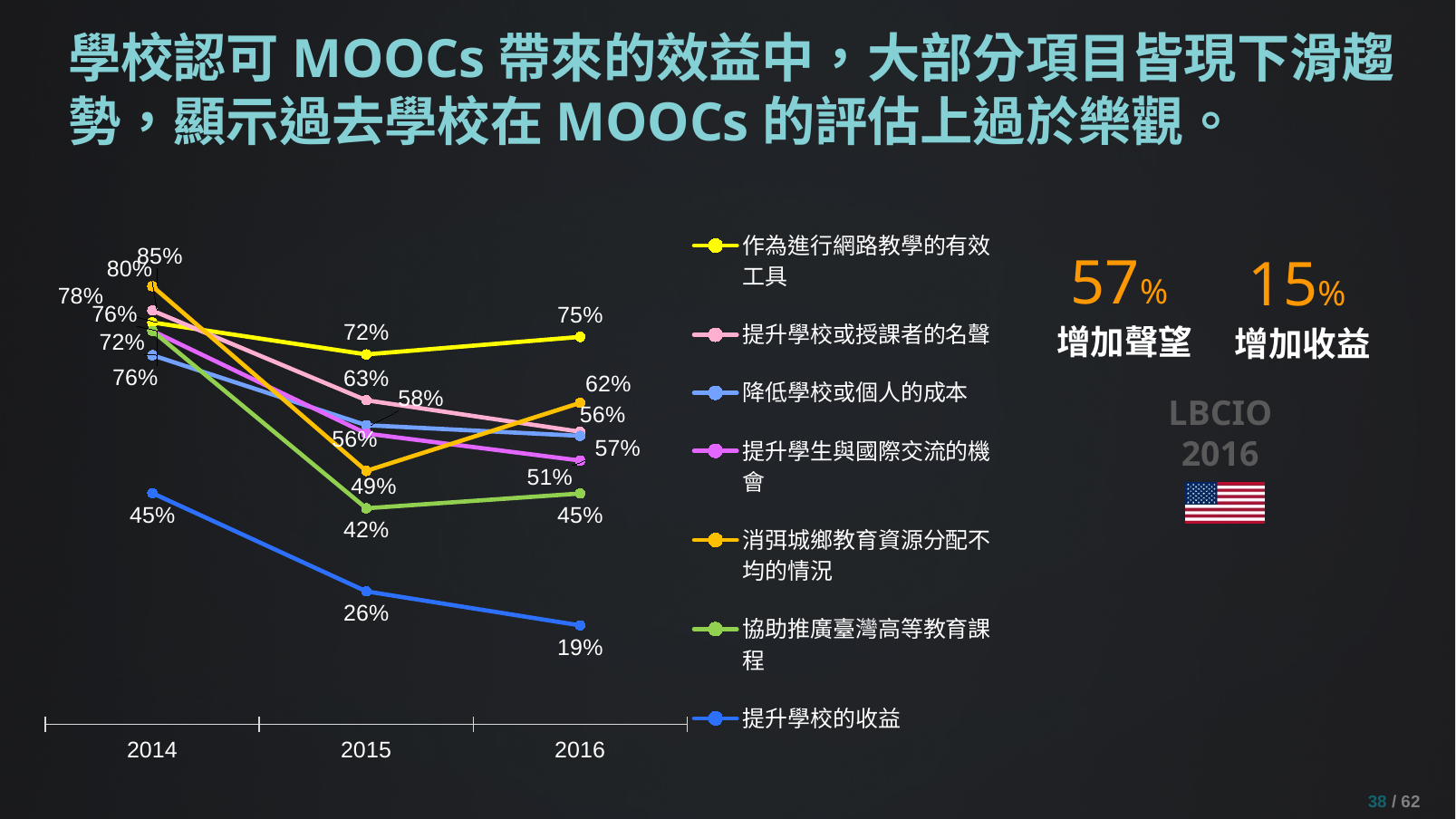
By how many percentage points did 提升學校的收益 fall from 2014 to 2016? 26 percentage points What is the value for 消弭城鄉教育資源分配不均的情況 in 2015? 49% Does the value for 提升學校的收益 rise or fall from 2014 to 2016? Fall What kind of chart is shown on the slide? Line chart How many years are shown on the x axis? 3 What is the value for 提升學校的收益 in 2016? 19% What is the value for 作為進行網路教學的有效工具 in 2016? 75% What is the value for 協助推廣臺灣高等教育課程 in 2015? 42% How many series does the legend list? 7 What is the value for 提升學校的收益 in 2014? 45% Which series has the highest value in 2016? 作為進行網路教學的有效工具 Which series has the lowest value in 2016? 提升學校的收益